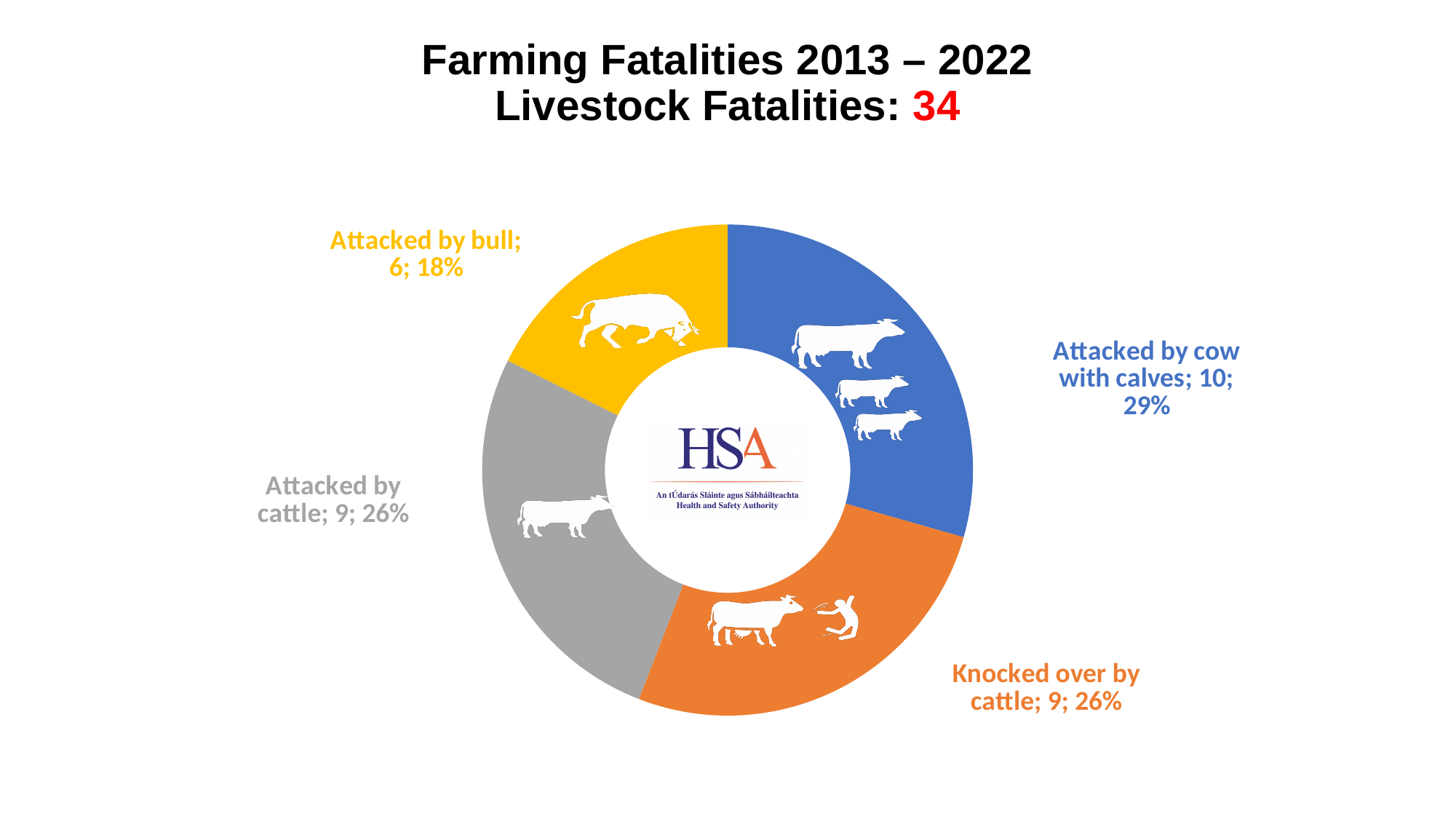
What percentage of livestock fatalities were due to being attacked by cattle? 26% Which is larger: fatalities from being attacked by a bull or from being knocked over by cattle? Knocked over by cattle What share of livestock fatalities were due to being attacked by a cow with calves? 29% What kind of chart is shown on the slide? Pie chart (doughnut) What is the total number of livestock fatalities stated in the chart title? 34 How many fatalities were caused by being attacked by a bull? 6 How many categories does the chart show? 4 How many fatalities were caused by being knocked over by cattle? 9 Which category accounts for the largest share of livestock fatalities? Attacked by cow with calves What is the difference between the number of fatalities from being attacked by a cow with calves and from being attacked by a bull? 4 Which category accounts for the smallest share of livestock fatalities? Attacked by bull How many livestock fatalities were attributed to being attacked by a cow with calves? 10